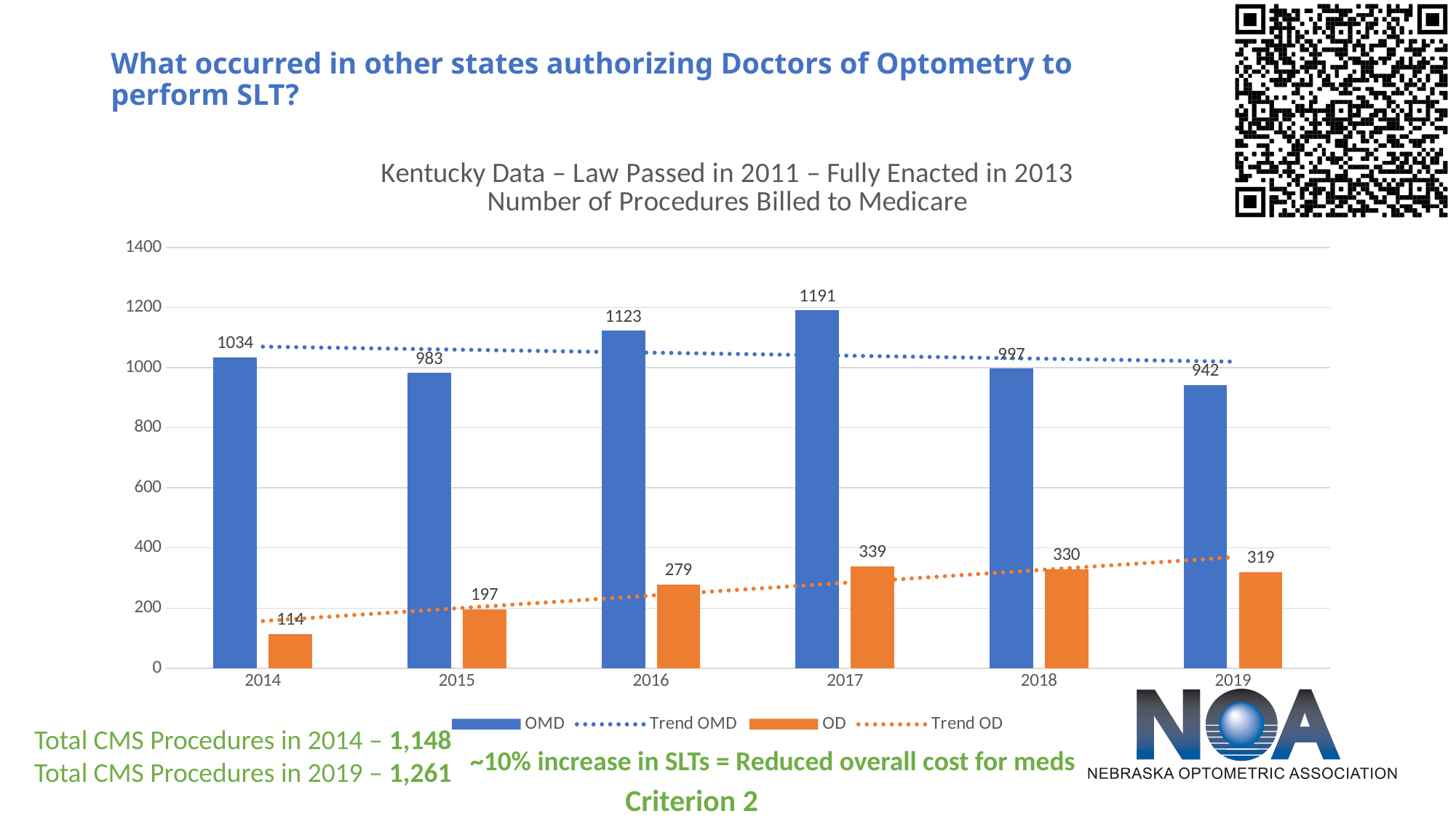
What kind of chart is shown on the slide? bar chart Is the OMD value for 2015 greater or less than 1000? less What is the difference between the OMD and OD values in 2019? 623 What is the OD value for 2014? 114 Which year has the lowest OMD value? 2019 Which is larger, the OD value in 2016 or the OD value in 2019? 2019 What is the OD value for 2018? 330 How many years are shown on the x axis? 6 How many entries does the legend list? 4 Which year has the highest OMD value? 2017 What is the OMD value for 2017? 1191 Which year has the lowest OD value? 2014